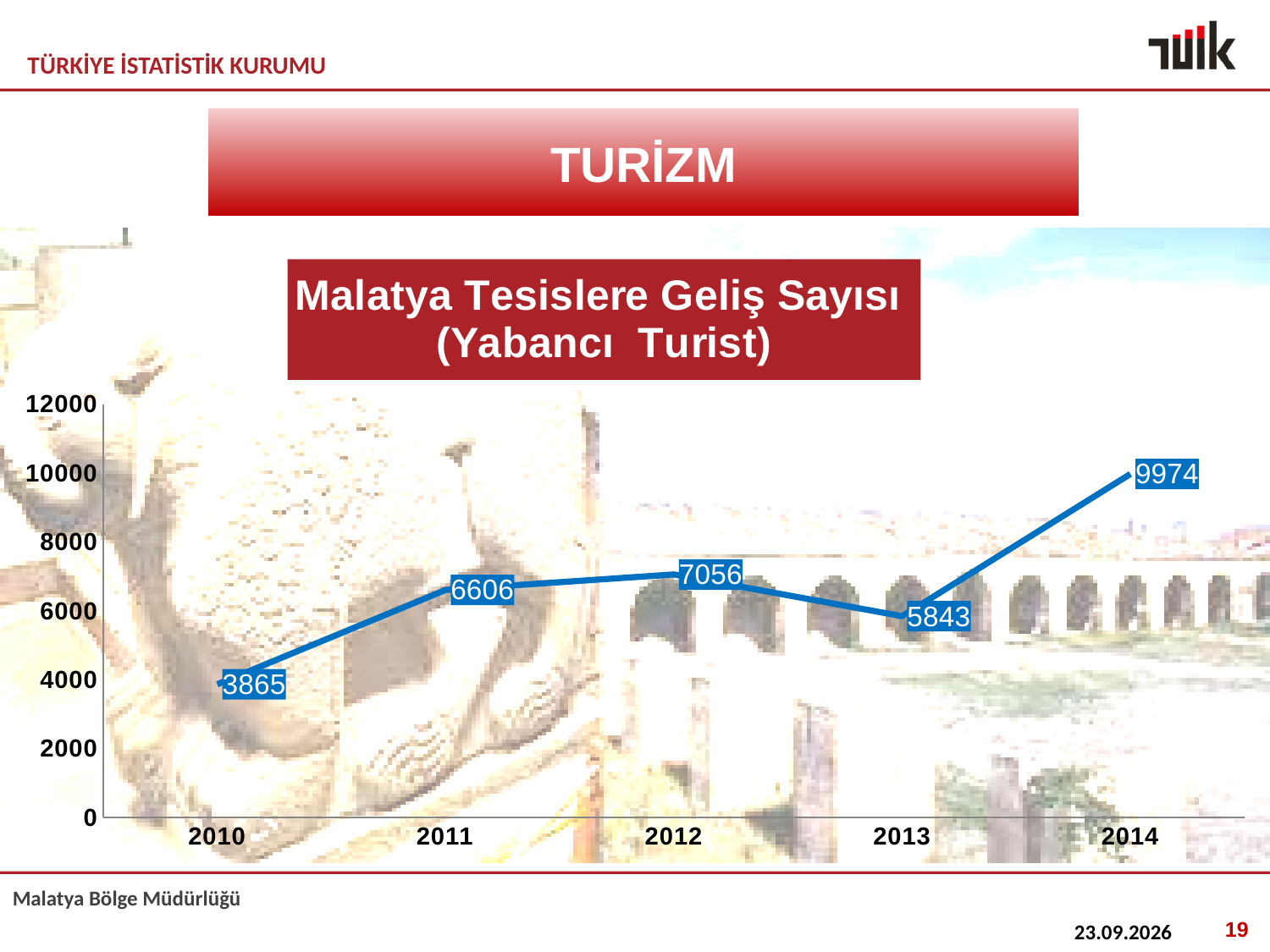
How many years are plotted on the chart? 5 Which year has the lowest value? 2010 Which year has the highest value? 2014 What is the difference between the values for 2014 and 2013? 4131 What kind of chart is shown? line chart What is the difference between the values for 2012 and 2011? 450 What is the value for 2010? 3865 What is the value for 2013? 5843 Is the value for 2011 greater or less than 6000? greater What is the value for 2014? 9974 What is the title of the chart? Malatya Tesislere Geliş Sayısı (Yabancı Turist) Which is larger, the value for 2012 or the value for 2013? 2012